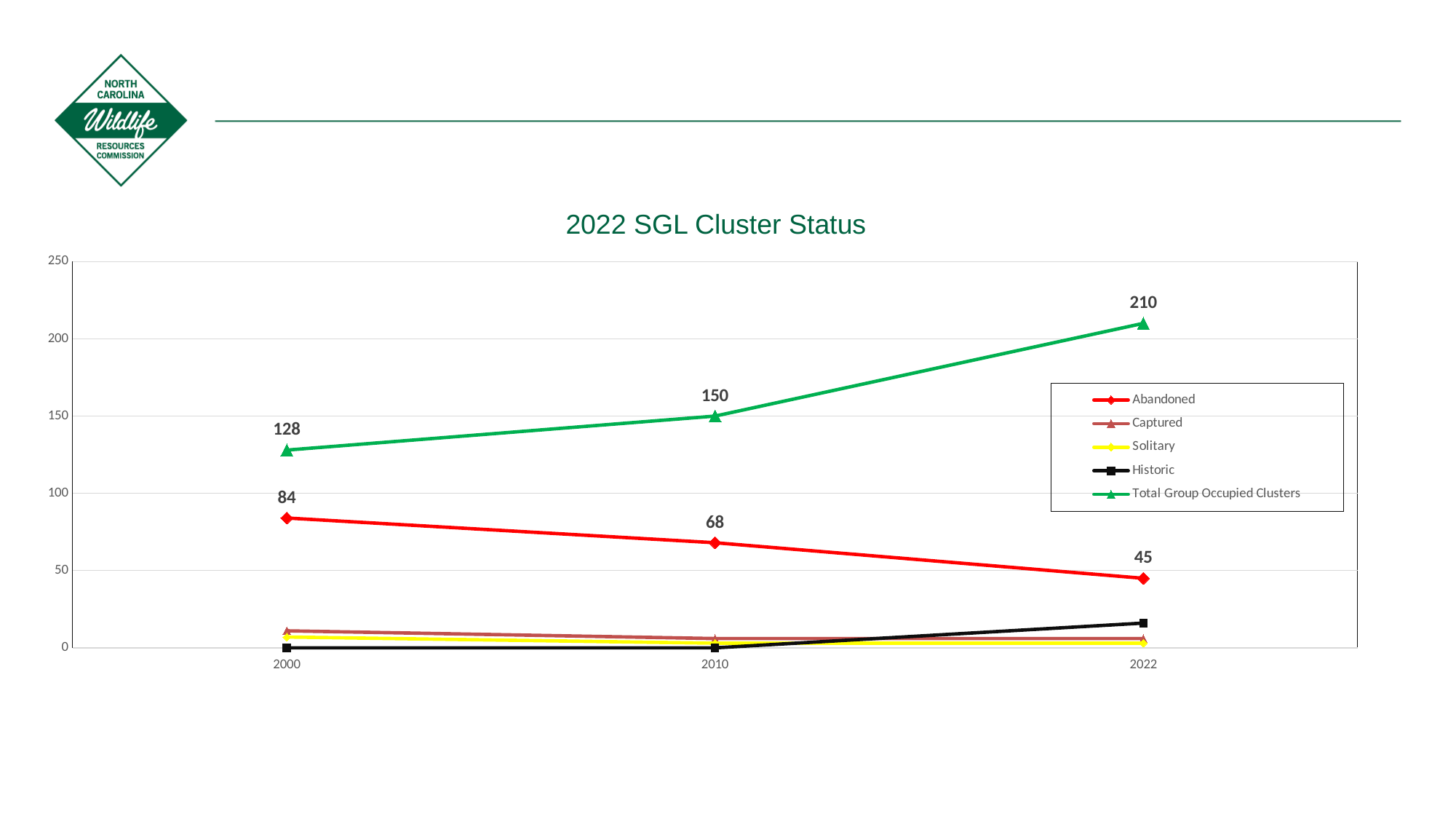
What is the value of Total Group Occupied Clusters in 2022? 210 What is the value of Abandoned in 2010? 68 What is the value of Total Group Occupied Clusters in 2000? 128 Does the Abandoned series rise or fall from 2000 to 2022? fall What is the difference between Total Group Occupied Clusters in 2022 and in 2000? 82 What is the value of Abandoned in 2000? 84 How many series does the legend list? 5 Which is larger in 2010: Total Group Occupied Clusters or Abandoned? Total Group Occupied Clusters In which year is Total Group Occupied Clusters highest? 2022 In which year is Abandoned lowest? 2022 What is the difference between Abandoned in 2000 and in 2022? 39 Is the value for Historic in 2022 greater or less than 50? less